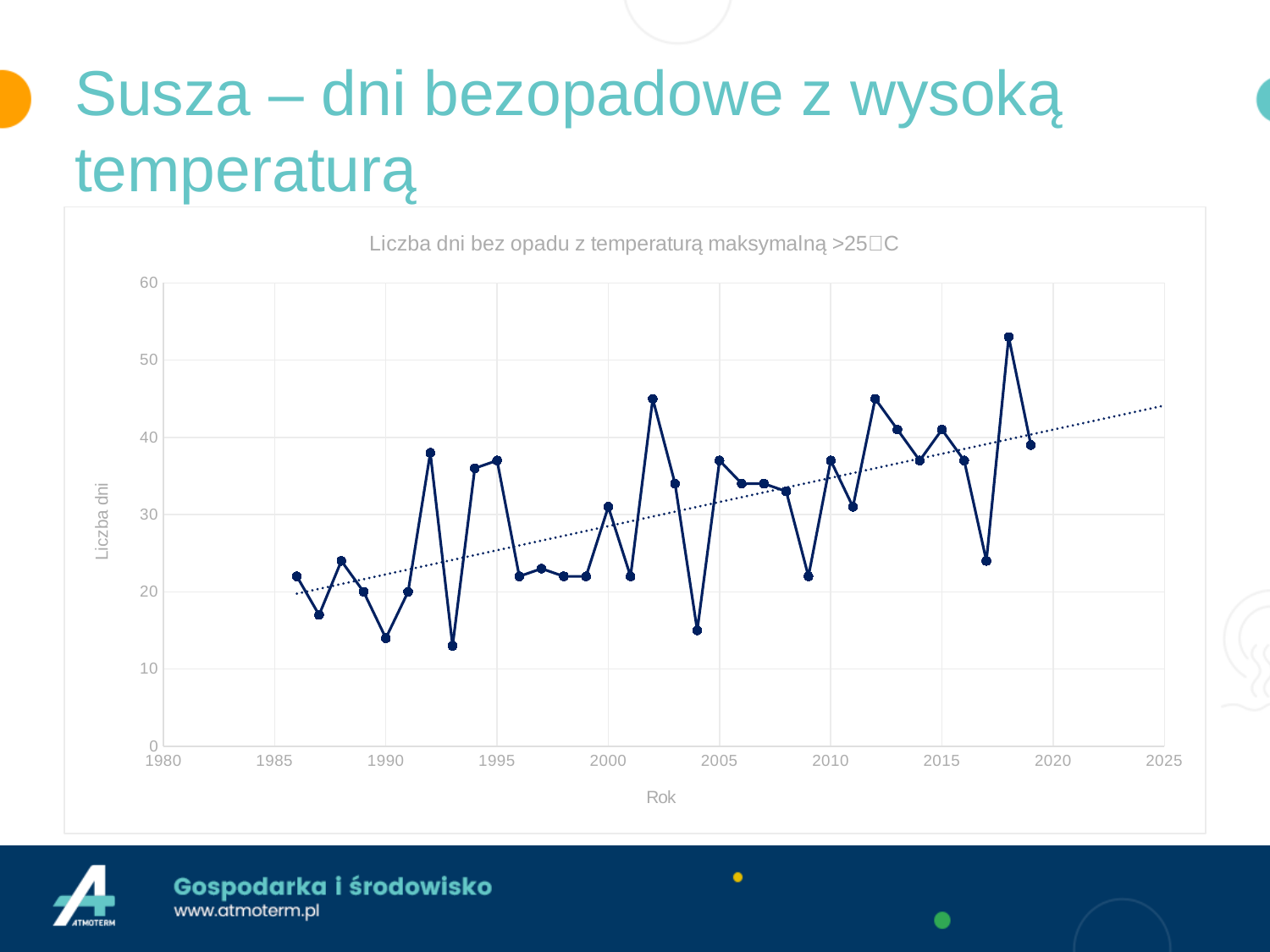
Is the value for 2002 greater or less than 40? greater What is the title of the chart? Liczba dni bez opadu z temperaturą maksymalną >25°C Is the value for 2018 greater or less than 50? greater Is the value for 2012 greater or less than 40? greater Which year has the larger value, 2018 or 2002? 2018 According to the dotted trend line, do the values rise or fall over the years? rise What is the label of the y axis? Liczba dni Which year has the larger value, 1990 or 1992? 1992 What kind of chart is shown on the slide? line chart In which year is the number of days highest? 2018